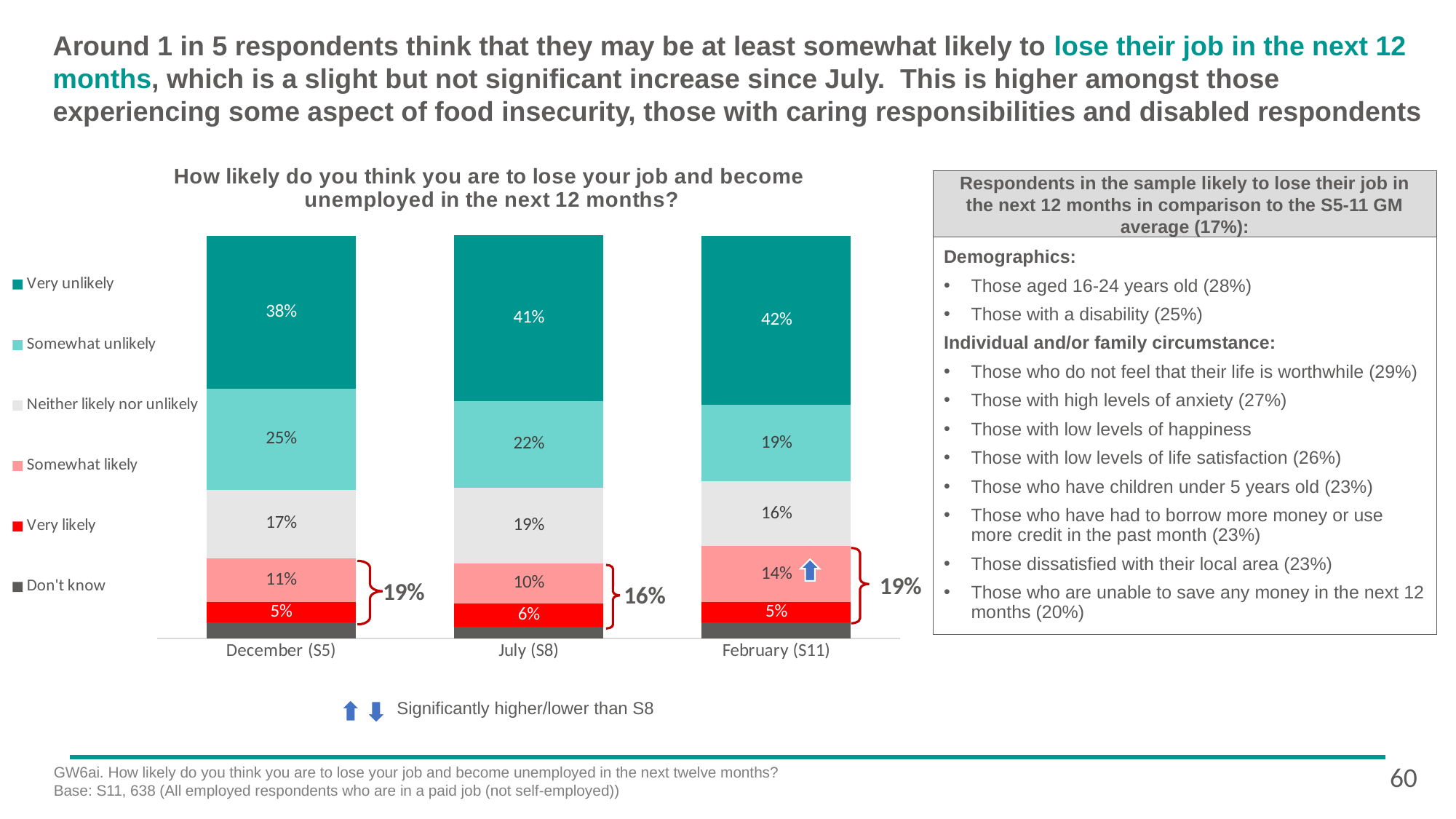
What percentage of respondents said 'Neither likely nor unlikely' in December (S5)? 17% How many series does the chart legend list? 6 How many survey waves are shown on the x axis of the chart? 3 Which is larger: the 'Somewhat unlikely' share in December (S5) or in July (S8)? December (S5) In which survey wave was the 'Somewhat unlikely' share the lowest? February (S11) In which survey wave was the 'Very unlikely' share the highest? February (S11) What percentage of respondents said 'Somewhat likely' in July (S8)? 10% What percentage of respondents said 'Very likely' in July (S8)? 6% What is the combined share of 'Somewhat likely' and 'Very likely' respondents in July (S8), as shown by the bracket? 16% What type of chart is used to show how likely respondents think they are to lose their job? Stacked bar chart What is the difference between the 'Somewhat likely' share in February (S11) and in July (S8)? 4 percentage points What percentage of respondents said 'Very unlikely' in February (S11)? 42%